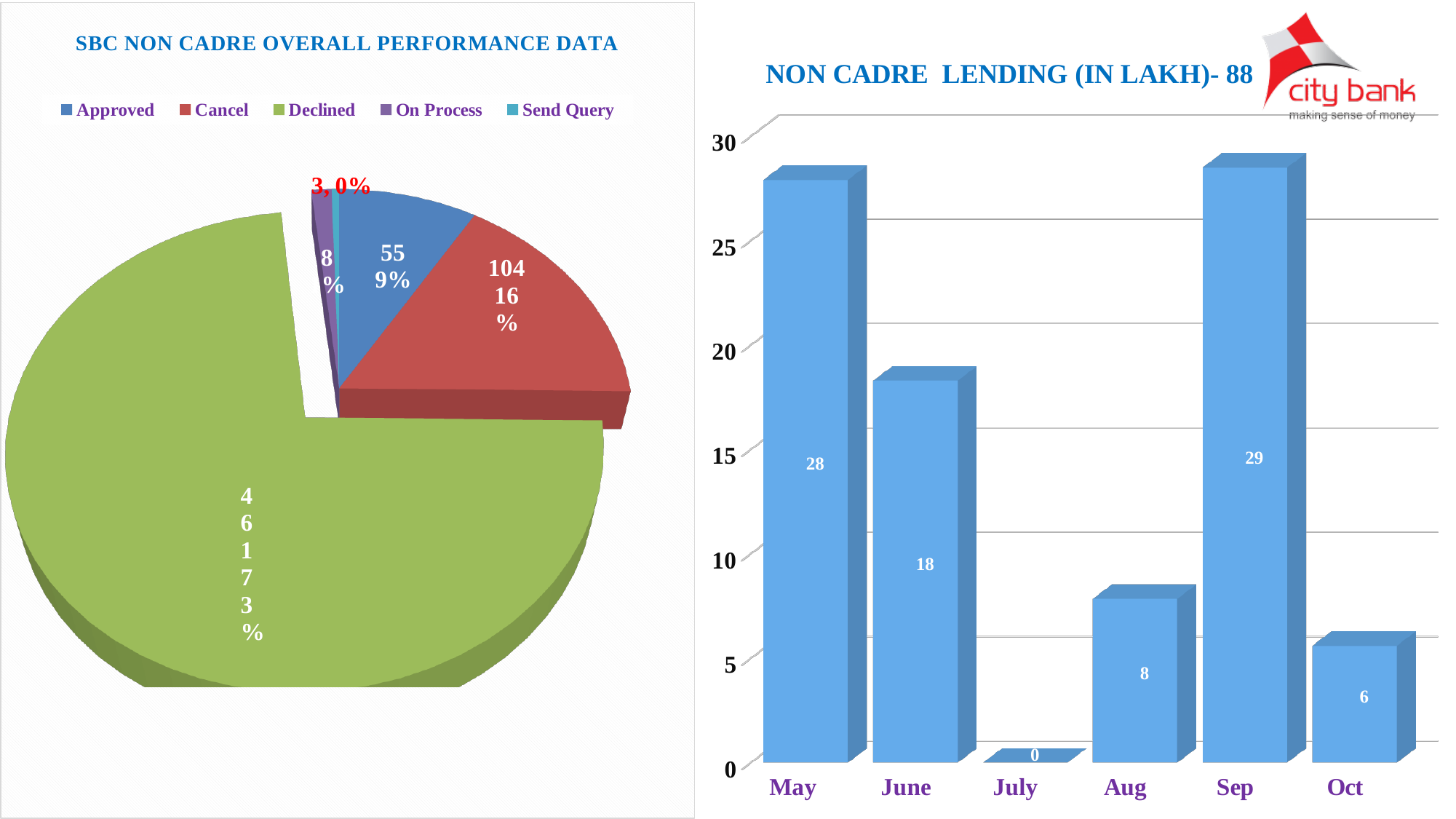
In the NON CADRE LENDING (IN LAKH) chart, what is the difference between the values for May and June? 10 In the NON CADRE LENDING (IN LAKH) chart, what is the value for May? 28 In the SBC NON CADRE OVERALL PERFORMANCE DATA pie chart, which category has the largest slice? Declined In the NON CADRE LENDING (IN LAKH) chart, what is the value for Sep? 29 How many months are shown in the NON CADRE LENDING (IN LAKH) chart? 6 In the NON CADRE LENDING (IN LAKH) chart, which is larger, the value for Aug or the value for Oct? Aug In the SBC NON CADRE OVERALL PERFORMANCE DATA pie chart, what is the count for Cancel? 104 In the SBC NON CADRE OVERALL PERFORMANCE DATA pie chart, what share does Declined have? 73% In the NON CADRE LENDING (IN LAKH) chart, which month has the lowest value? July What kind of chart is the NON CADRE LENDING (IN LAKH) chart? bar chart How many categories does the legend of the SBC NON CADRE OVERALL PERFORMANCE DATA pie chart list? 5 In the NON CADRE LENDING (IN LAKH) chart, which month has the highest value? Sep